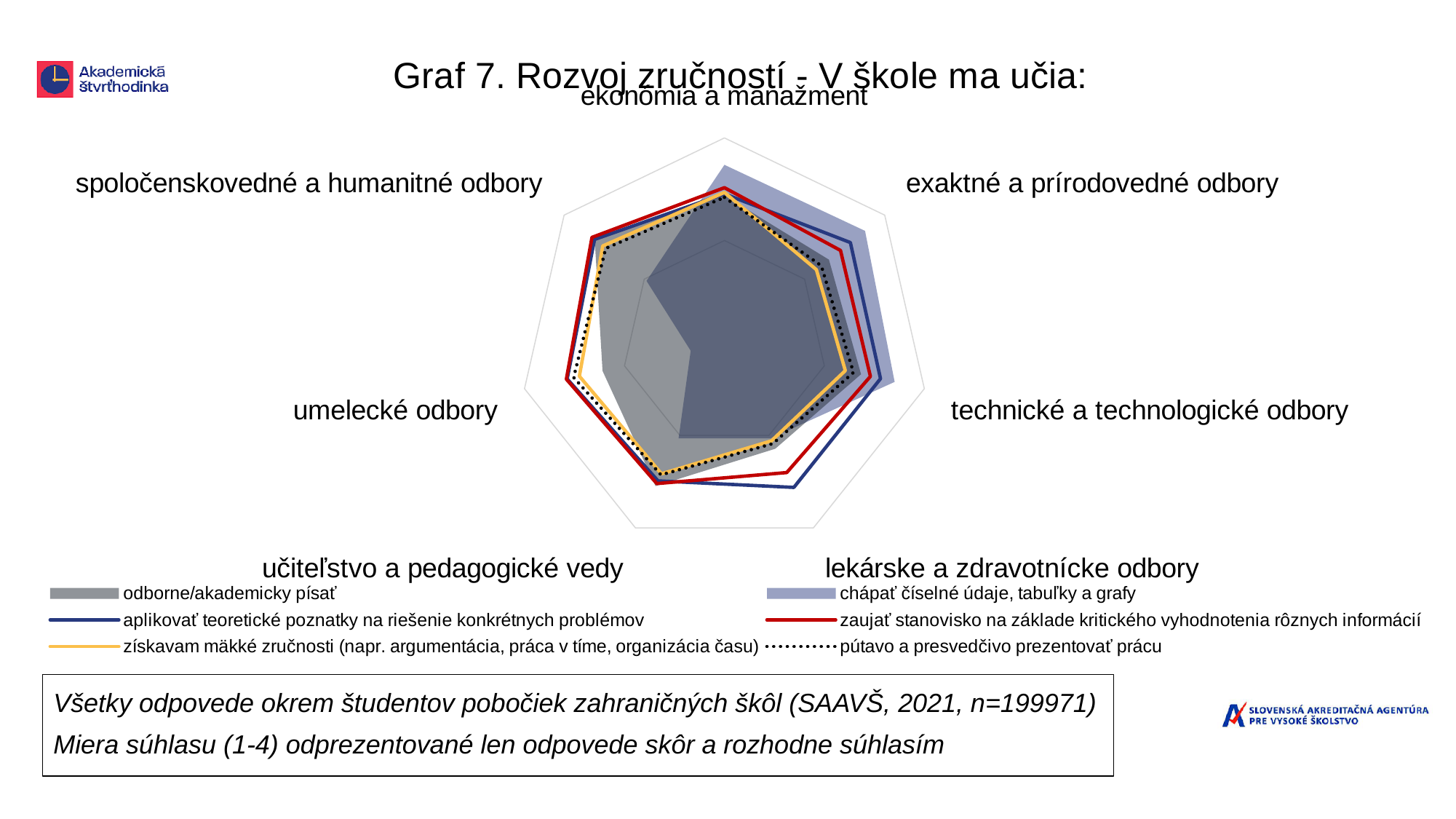
How many series does the legend of the chart list? 6 For the series 'chápať číselné údaje, tabuľky a grafy', is the value for exaktné a prírodovedné odbory or for spoločenskovedné a humanitné odbory larger? exaktné a prírodovedné odbory For the series 'chápať číselné údaje, tabuľky a grafy', is the value for ekonómia a manažment or for umelecké odbory larger? ekonómia a manažment What kind of chart is shown on the slide? radar chart Which series is drawn as a dotted black line in the chart? pútavo a presvedčivo prezentovať prácu What is the title of the chart? Graf 7. Rozvoj zručností - V škole ma učia: How many fields of study (categories) are plotted around the radar chart? 7 For the series 'chápať číselné údaje, tabuľky a grafy', which category has the lowest value? umelecké odbory